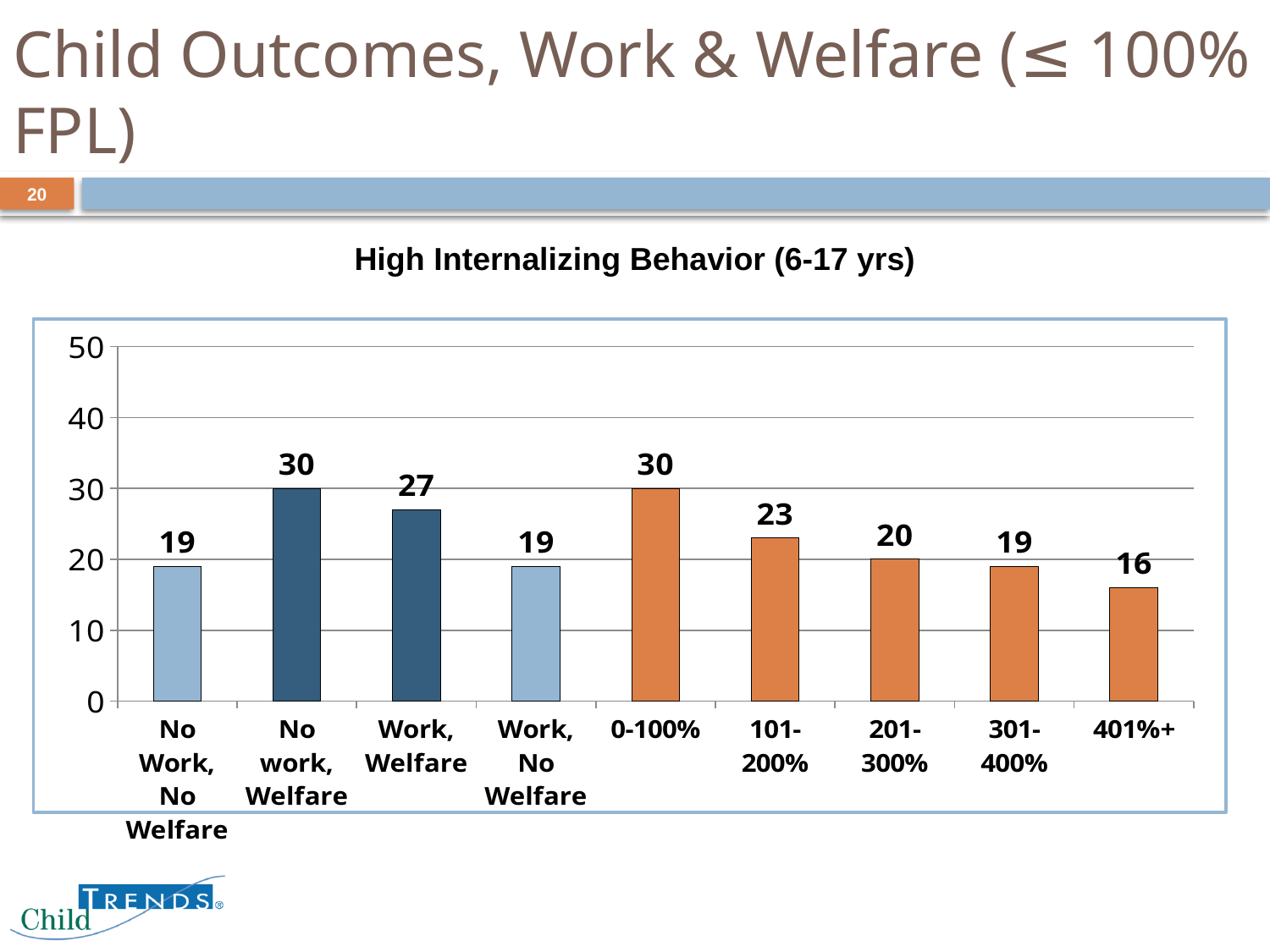
What is the difference between the values for "0-100%" and "201-300%"? 10 What is the title of the chart? High Internalizing Behavior (6-17 yrs) What is the value for the "101-200%" category? 23 What is the difference between the values for "No work, Welfare" and "Work, No Welfare"? 11 Which is larger, the value for "Work, Welfare" or the value for "101-200%"? Work, Welfare Is the value for "No Work, No Welfare" greater or less than 20? less What is the value for the "Work, Welfare" category? 27 What is the value for the "401%+" category? 16 Do the values rise or fall from "0-100%" to "401%+"? fall How many categories are shown on the x axis? 9 Which category has the lowest value? 401%+ What kind of chart is shown on the slide? bar chart